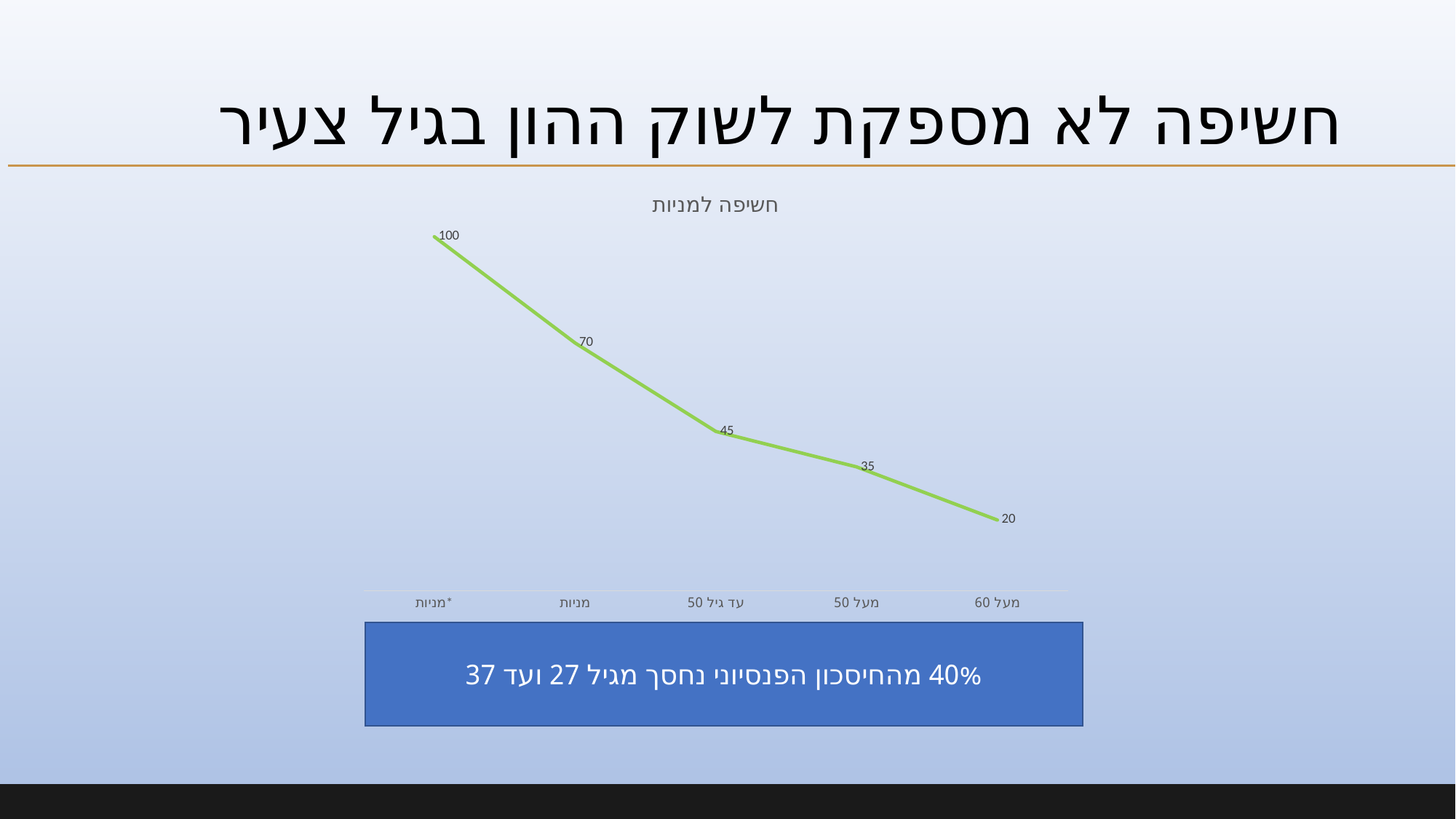
What is the difference between the values for "מניות" and "עד גיל 50"? 25 How many categories are plotted on the x axis of the chart? 5 Do the values rise or fall from left to right along the x axis? fall What is the value for "עד גיל 50" in the chart? 45 What is the value for "מעל 50" in the chart? 35 Which category has the highest value in the chart? מניות* Which is larger, the value for "מעל 50" or the value for "מעל 60"? מעל 50 What kind of chart is shown on the slide? line chart Which category has the lowest value in the chart? מעל 60 What is the value for "מניות*" in the chart? 100 What is the title of the chart? חשיפה למניות What is the value for "מעל 60" in the chart? 20